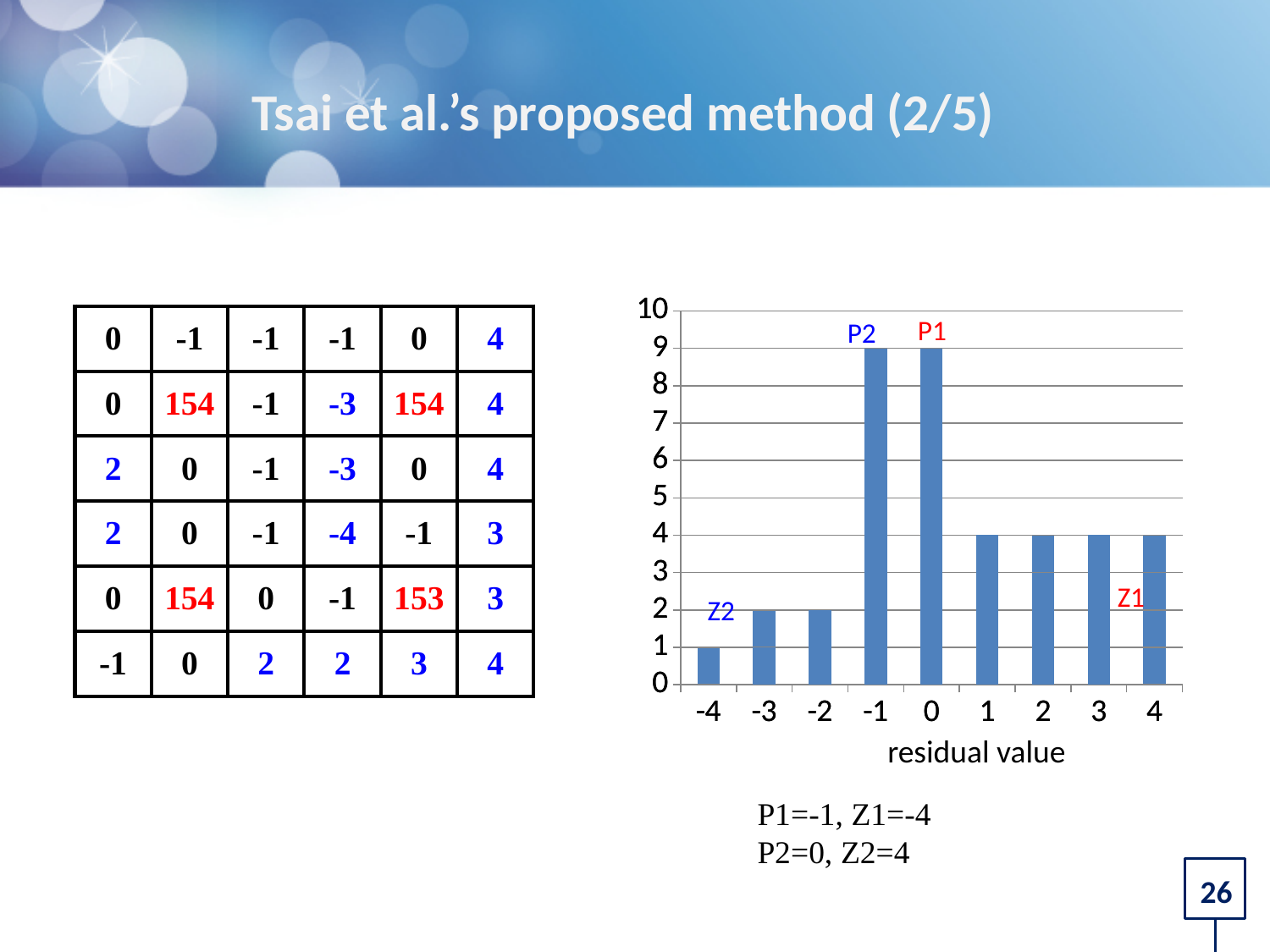
Which residual value has the lowest bar? -4 Which bar in the chart is labelled Z1? residual value 4 What is the difference between the bar heights for residual values -1 and -4? 8 What is the bar height for residual value -4? 1 What is the x-axis title of the chart? residual value Is the bar for residual value -1 greater or less than 5? greater What is the bar height for residual value -3? 2 Which bar is taller, residual value 0 or residual value 1? 0 What is the bar height for residual value 2? 4 What is the bar height for residual value -1? 9 What kind of chart is shown on the slide? bar chart How many residual value categories are shown on the x axis of the chart? 9